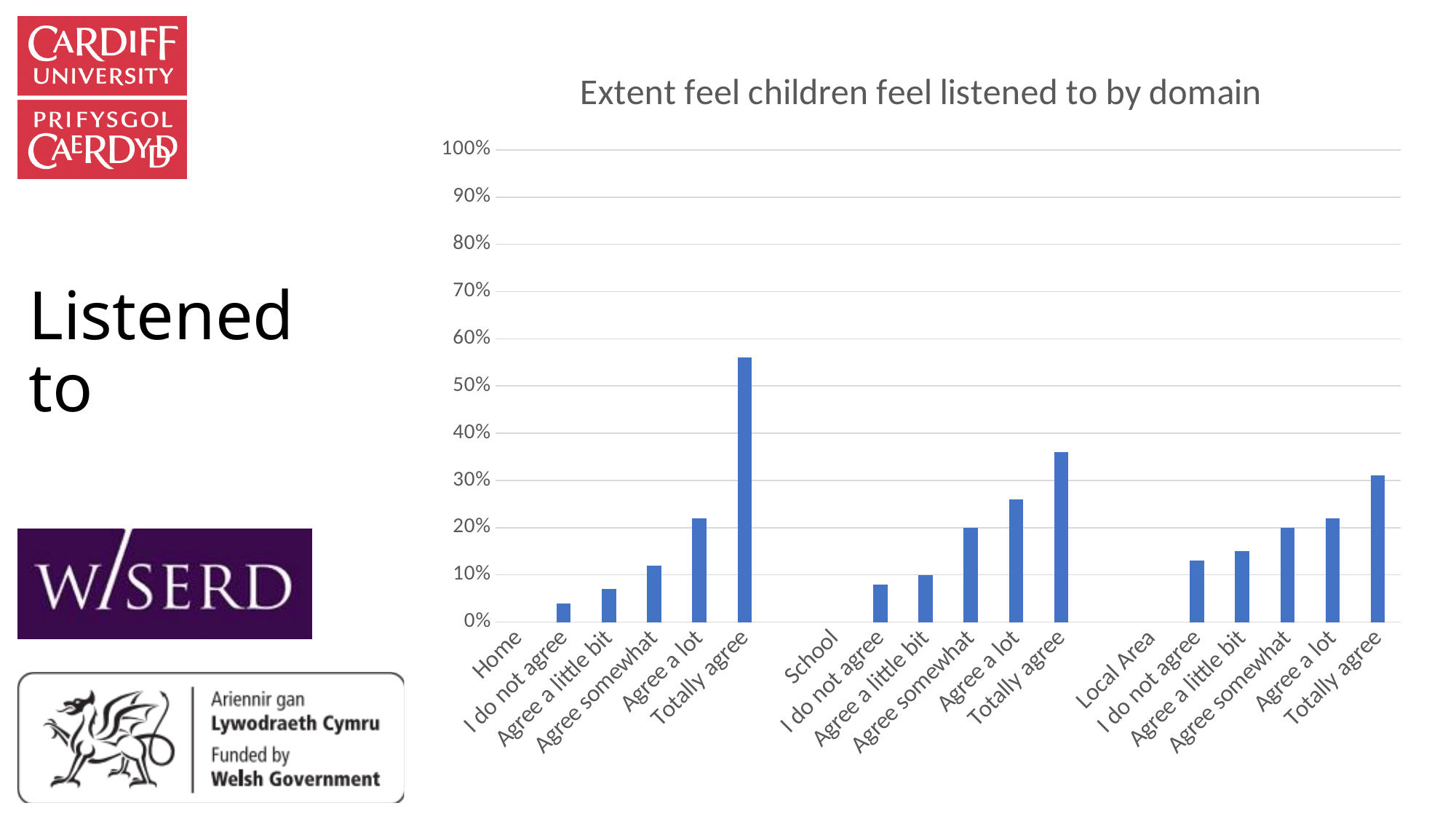
Which bar is the highest in the chart? Totally agree (Home) Is the value for Totally agree under School greater or less than 40%? less Which is larger: Totally agree under Home or Totally agree under School? Totally agree under Home What is the title of the chart? Extent feel children feel listened to by domain Which is larger: I do not agree under Local Area or I do not agree under Home? I do not agree under Local Area Is the value for Totally agree under Home greater or less than 50%? greater What kind of chart is shown on the slide? bar chart Is the value for Totally agree under Local Area greater or less than 40%? less Within the Home domain, do the bars rise or fall from I do not agree to Totally agree? rise How many domains (Home, School, Local Area) are shown on the x axis? 3 Which bar is the lowest in the chart? I do not agree (Home)